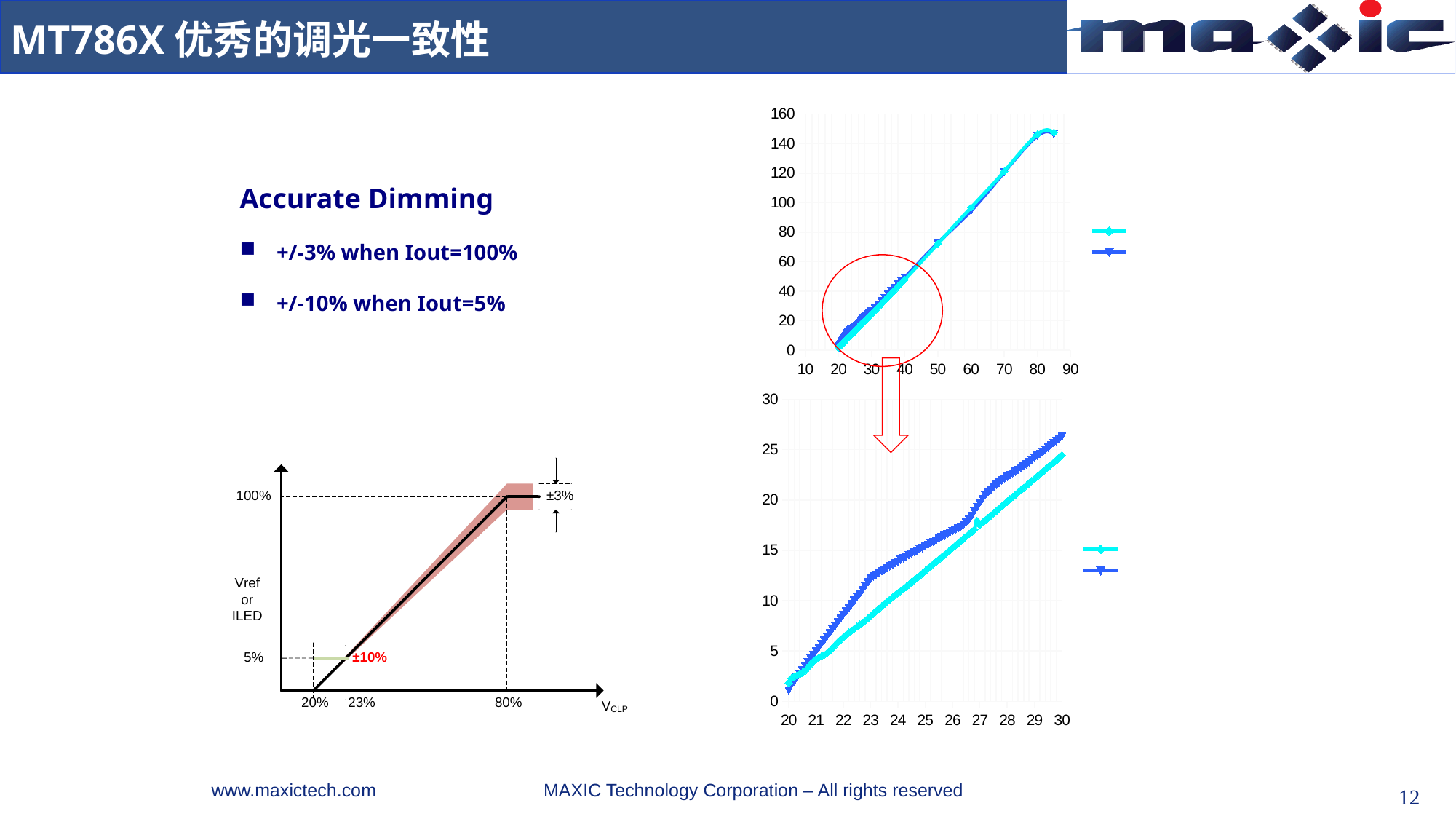
In the bottom chart on the right, do the plotted values rise or fall as the x axis goes from 20 to 30? rise In the top chart on the right, is the value at x = 80 greater or less than 120? greater In the top chart on the right, how many series does the legend show? 2 In the bottom chart on the right, is the dark blue series value at x = 30 greater or less than 20? greater In the bottom chart on the right, how many series does the legend show? 2 In the bottom chart on the right, is the cyan series value at x = 23 greater or less than 10? less What kind of chart is the bottom chart on the right side of the slide? line chart In the bottom chart on the right, how many tick labels are shown on the x axis? 11 What kind of chart is the top chart on the right side of the slide? line chart In the top chart on the right, do the plotted values rise or fall as the x axis goes from 10 to 80? rise In the bottom chart on the right, at x = 25, which series has the higher value, the cyan one or the dark blue one? dark blue